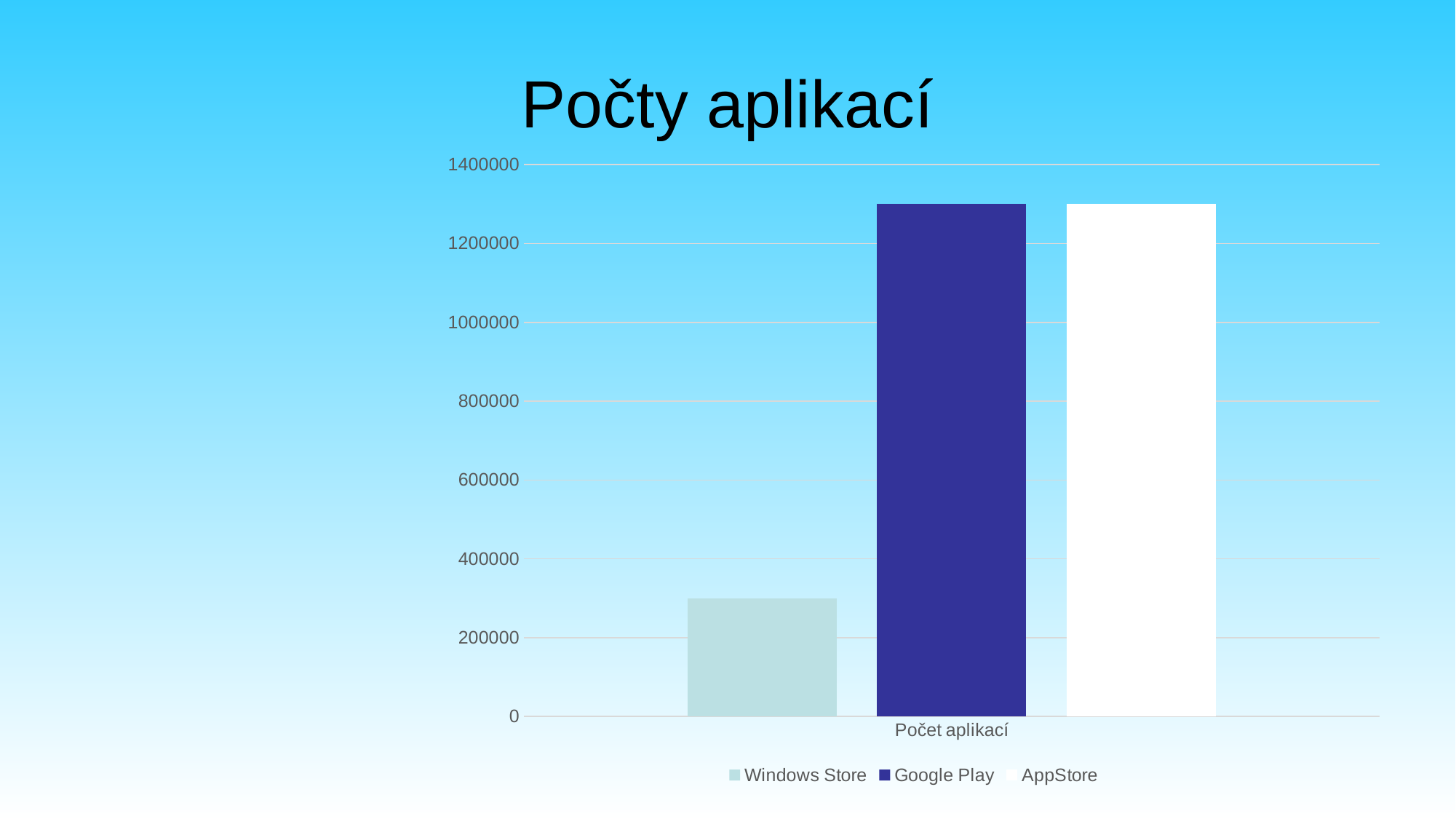
What kind of chart is shown on the slide? bar chart What is the title of the chart? Počty aplikací Is the value for AppStore greater or less than 1400000? less Is the value for Google Play greater or less than 1200000? greater How many categories are shown on the x axis? 1 Which series has the lowest value? Windows Store Is the value for Windows Store greater or less than 400000? less Which series are listed in the legend? Windows Store, Google Play, AppStore Which is larger, the value for Windows Store or the value for Google Play? Google Play Which is larger, the value for AppStore or the value for Windows Store? AppStore How many series does the legend list? 3